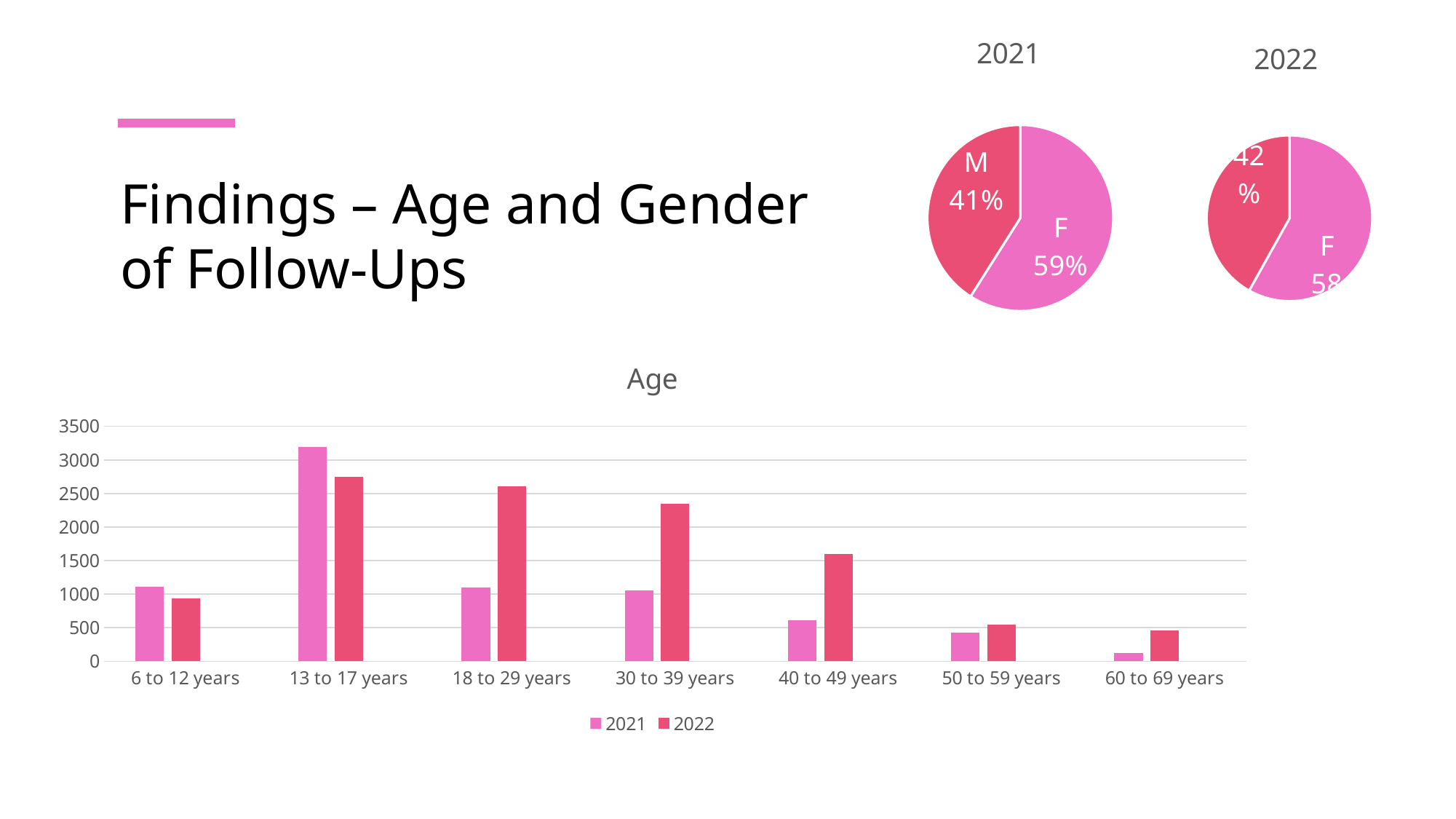
In the Age chart, which age category has the highest 2021 value? 13 to 17 years What kind of chart is the chart titled Age? bar chart In the Age chart, how many age categories are shown on the x axis? 7 In the Age chart, for 18 to 29 years, which series has the larger value, 2021 or 2022? 2022 In the 2021 pie chart, what share is labelled F? 59% In the Age chart, is the 2021 value for 13 to 17 years greater or less than 3000? greater In the 2021 pie chart, which slice is larger, M or F? F In the Age chart, which age category has the lowest 2021 value? 60 to 69 years In the 2022 pie chart, what share is shown for the M slice? 42% In the Age chart, is the 2022 value for 18 to 29 years greater or less than 2500? greater In the 2021 pie chart, what share is labelled M? 41% In the Age chart, how many series does the legend list? 2